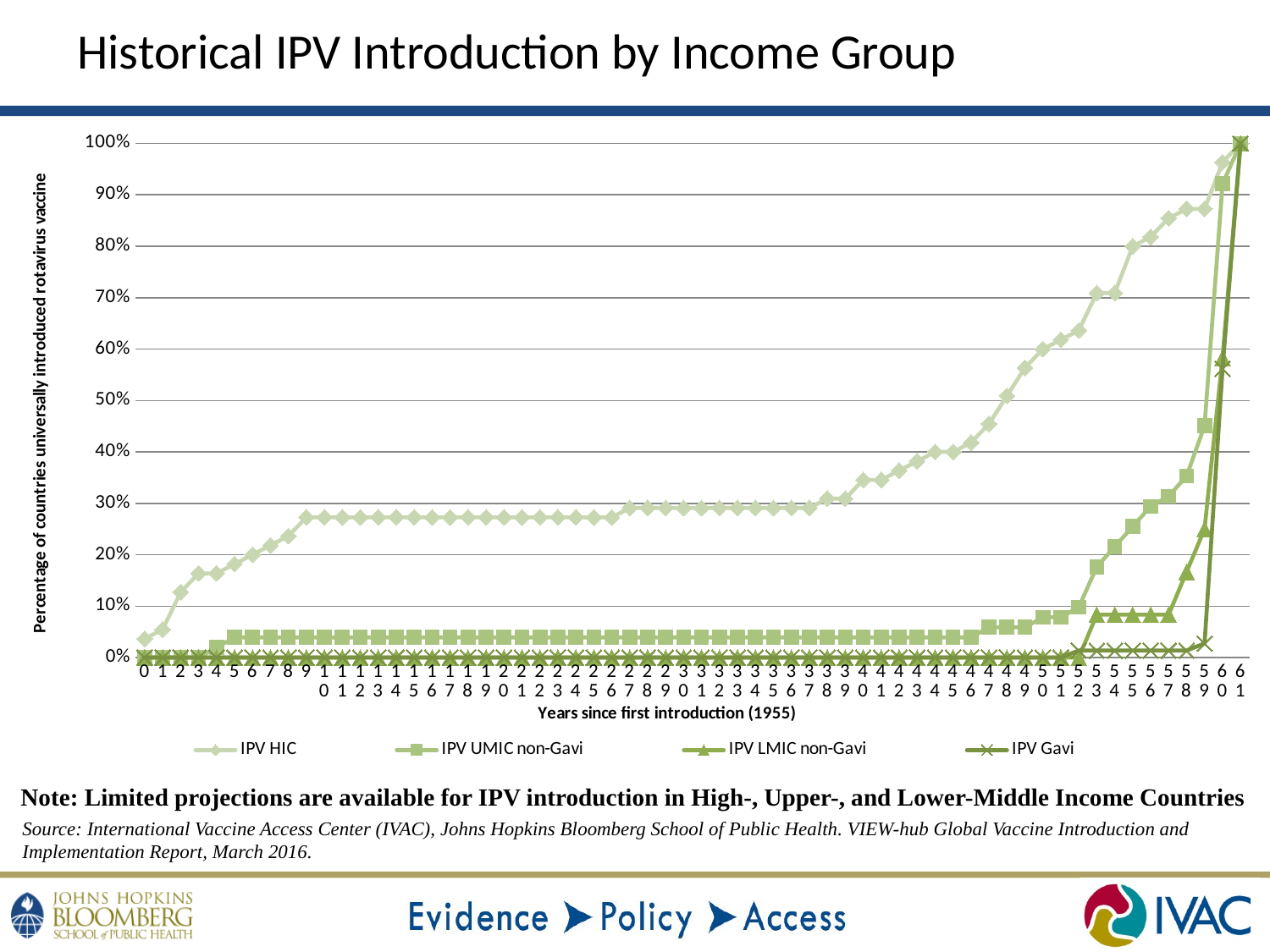
What is the value of the IPV Gavi series at year 0? 0% Which series has the highest value at year 50? IPV HIC How many series does the legend list? 4 Is the value for IPV Gavi at year 60 greater or less than 50%? greater What kind of chart is shown on the slide? line chart Is the value for IPV UMIC non-Gavi at year 59 greater or less than 40%? greater At year 40, which series has the larger value, IPV HIC or IPV UMIC non-Gavi? IPV HIC What is the title of the x axis? Years since first introduction (1955) Do the values of the IPV HIC series generally rise or fall along the x axis? rise Is the value for IPV LMIC non-Gavi at year 55 greater or less than 10%? less What value does the IPV HIC series reach at year 61? 100%